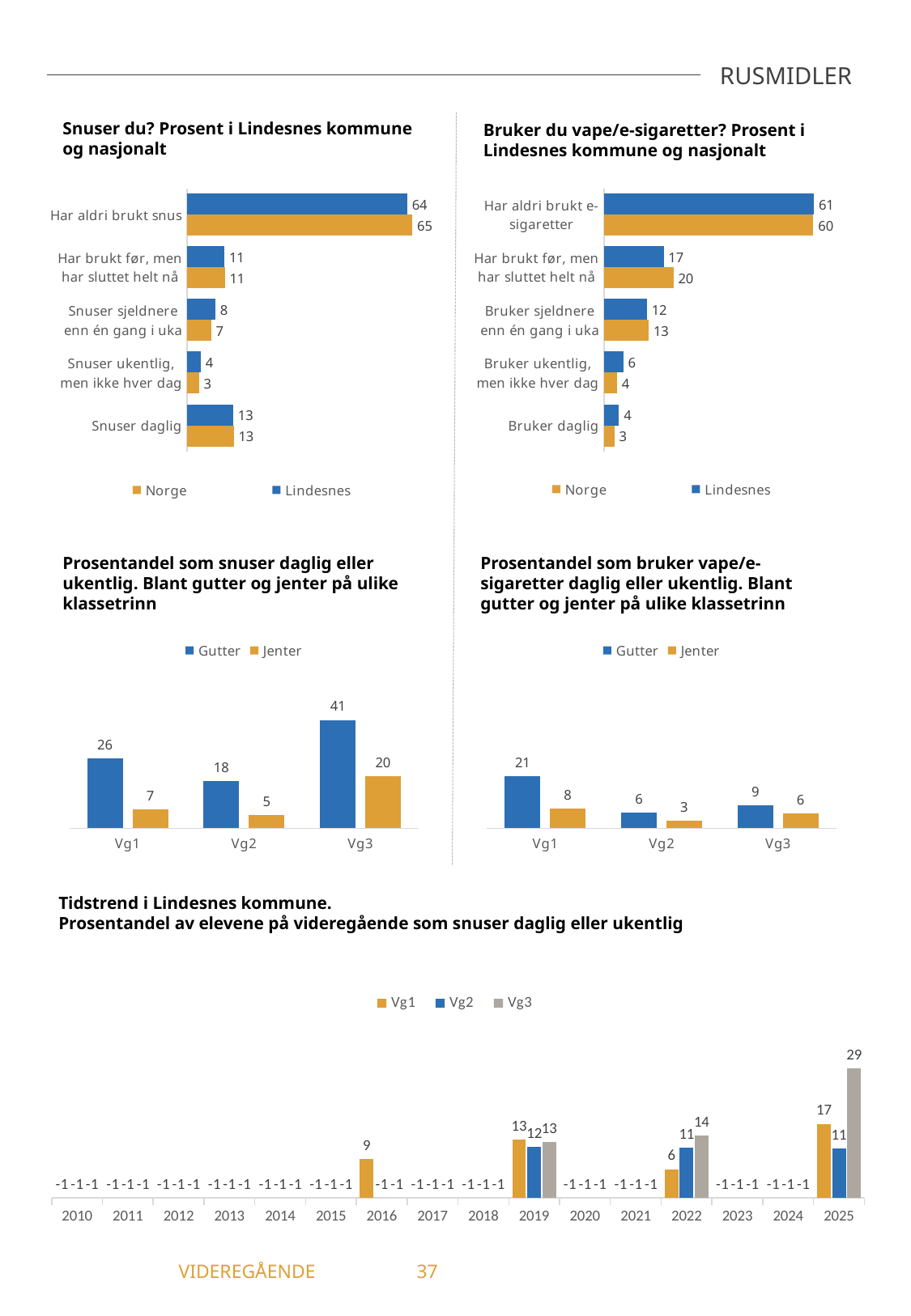
What kind of chart is 'Tidstrend i Lindesnes kommune'? Bar chart In the chart 'Bruker du vape/e-sigaretter? Prosent i Lindesnes kommune og nasjonalt', what is the difference between Lindesnes and Norge for 'Bruker ukentlig, men ikke hver dag'? 2 In the chart 'Prosentandel som snuser daglig eller ukentlig. Blant gutter og jenter på ulike klassetrinn', which class level has the highest value for Gutter? Vg3 In the chart 'Prosentandel som snuser daglig eller ukentlig. Blant gutter og jenter på ulike klassetrinn', what is the value for Jenter at Vg2? 5 In the chart 'Prosentandel som snuser daglig eller ukentlig. Blant gutter og jenter på ulike klassetrinn', what is the difference between Gutter and Jenter at Vg3? 21 In the chart 'Bruker du vape/e-sigaretter? Prosent i Lindesnes kommune og nasjonalt', what is the value for Norge for 'Har brukt før, men har sluttet helt nå'? 20 In the chart 'Tidstrend i Lindesnes kommune', what is the value for Vg3 in 2025? 29 In the chart 'Snuser du? Prosent i Lindesnes kommune og nasjonalt', what is the value for Lindesnes for 'Har aldri brukt snus'? 64 In the chart 'Snuser du? Prosent i Lindesnes kommune og nasjonalt', what is the value for Norge for 'Snuser daglig'? 13 In the chart 'Prosentandel som bruker vape/e-sigaretter daglig eller ukentlig. Blant gutter og jenter på ulike klassetrinn', which is larger at Vg1: Gutter or Jenter? Gutter In the chart 'Bruker du vape/e-sigaretter? Prosent i Lindesnes kommune og nasjonalt', how many series does the legend list? 2 In the chart 'Prosentandel som bruker vape/e-sigaretter daglig eller ukentlig. Blant gutter og jenter på ulike klassetrinn', which class level has the lowest value for Jenter? Vg2